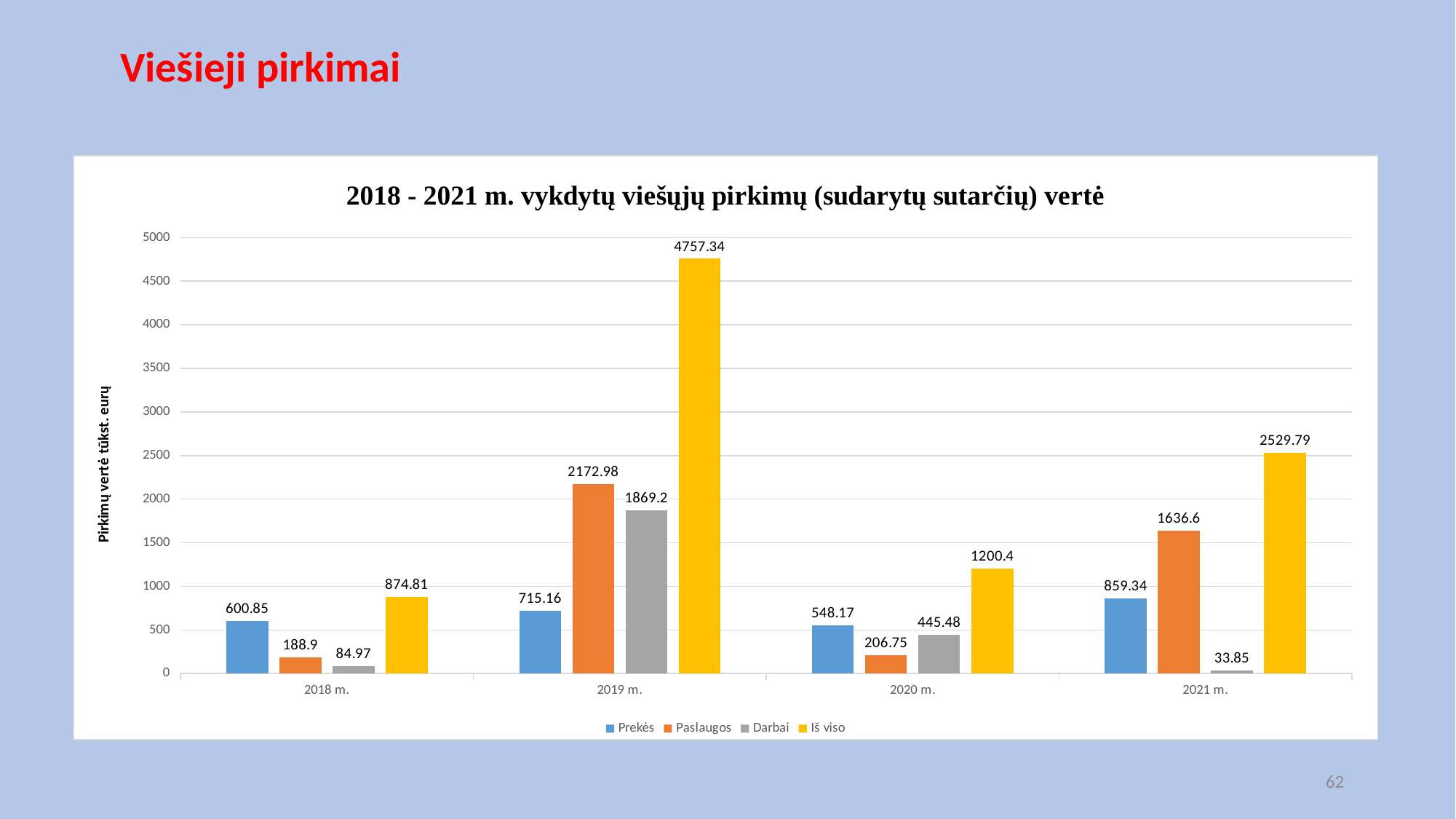
What kind of chart is shown on the slide? Bar chart What is the difference between the Prekės values for 2021 m. and 2018 m.? 258.49 What is the value for Darbai in 2020 m.? 445.48 In which year is the Iš viso value highest? 2019 m. In which year is the Darbai value lowest? 2021 m. How many series does the legend list? 4 Which is larger in 2020 m., Paslaugos or Darbai? Darbai How many years are shown on the x axis? 4 What is the value for Prekės in 2019 m.? 715.16 What is the difference between the Paslaugos values for 2019 m. and 2021 m.? 536.38 What is the label of the vertical axis? Pirkimų vertė tūkst. eurų What is the value for Iš viso in 2021 m.? 2529.79